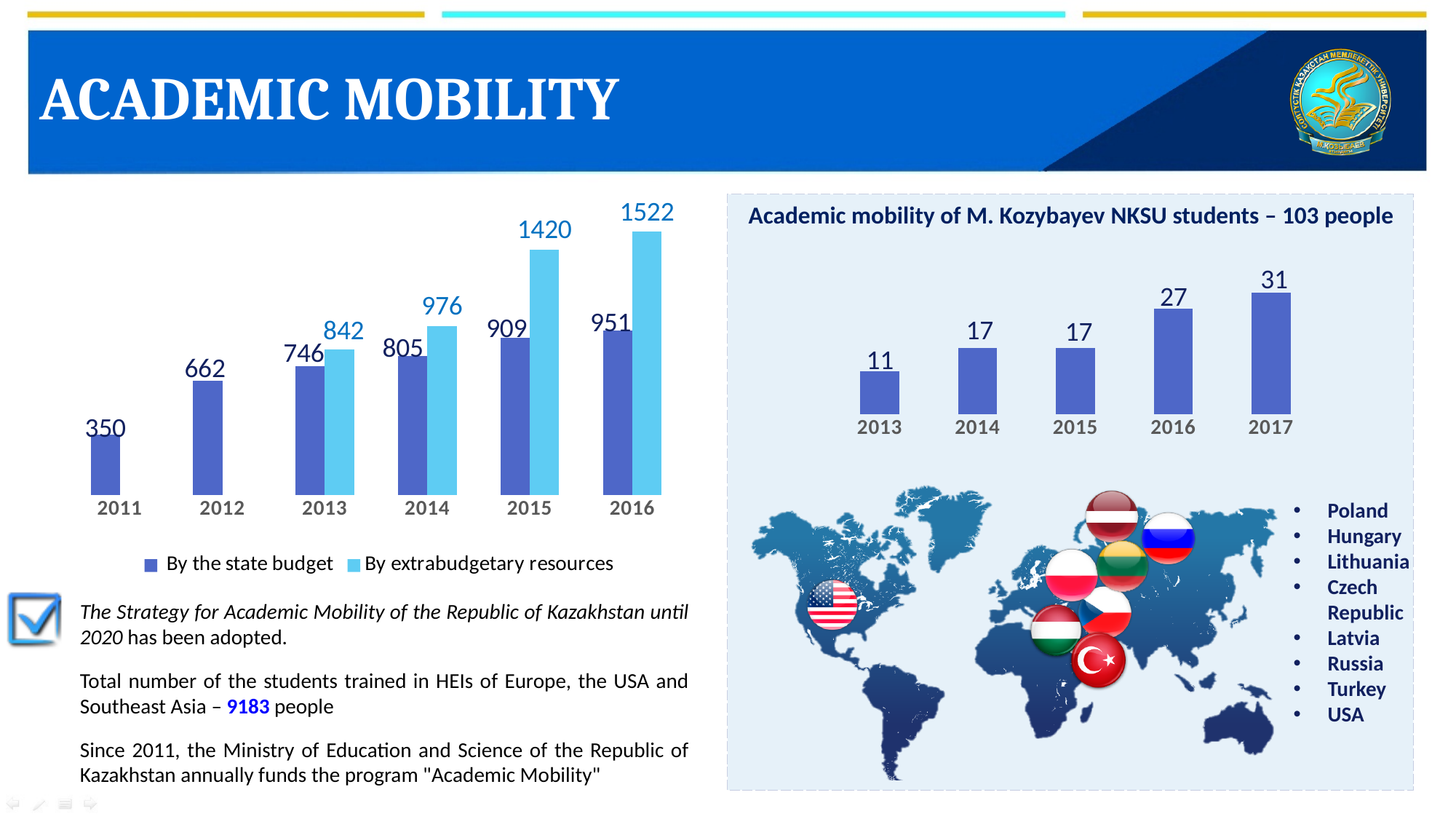
How many years are shown on the x axis of the left chart? 6 In the left chart, what is the difference between 'By extrabudgetary resources' and 'By the state budget' in 2015? 511 In the left chart, which year has the highest value for 'By the state budget'? 2016 What kind of chart is the chart titled 'Academic mobility of M. Kozybayev NKSU students – 103 people'? Bar chart How many series does the legend of the left chart list? 2 In the left chart, which is larger in 2014: 'By the state budget' or 'By extrabudgetary resources'? By extrabudgetary resources In the chart titled 'Academic mobility of M. Kozybayev NKSU students – 103 people', which year has the lowest value? 2013 In the left chart, what is the value for 'By the state budget' in 2011? 350 In the left chart, what is the value for 'By the state budget' in 2015? 909 In the chart titled 'Academic mobility of M. Kozybayev NKSU students – 103 people', what is the value for 2016? 27 In the left chart, what is the value for 'By extrabudgetary resources' in 2016? 1522 In the chart titled 'Academic mobility of M. Kozybayev NKSU students – 103 people', what is the difference between 2017 and 2013? 20